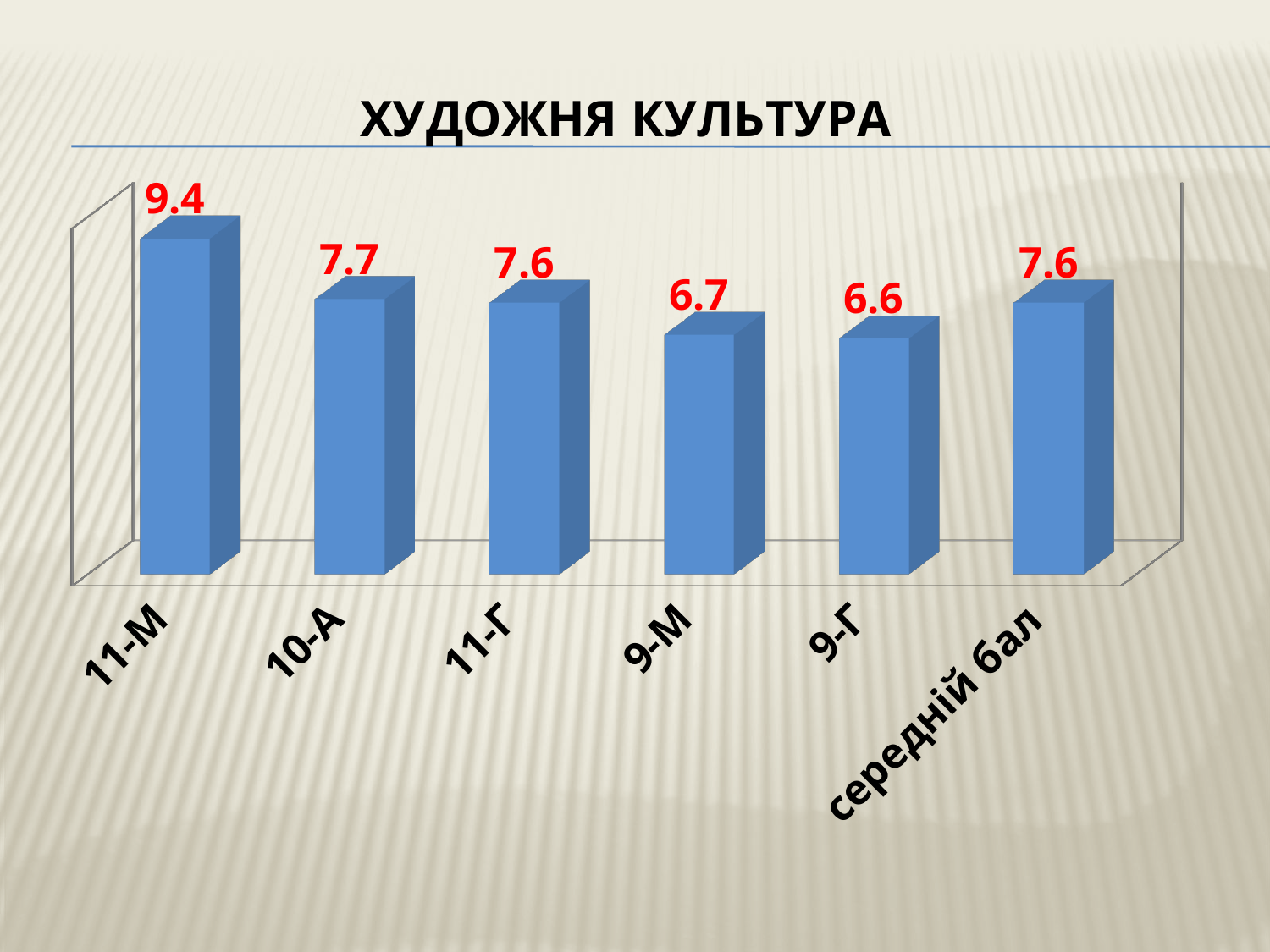
What is the title of the chart? ХУДОЖНЯ КУЛЬТУРА What is the difference between the values for 10-А and 9-М? 1.0 Which category has the lowest value? 9-Г Which is larger, the value for 11-Г or the value for 9-М? 11-Г Which category has the highest value? 11-М What is the value for 10-А? 7.7 What kind of chart is shown on the slide? bar chart What is the difference between the values for 11-М and 9-Г? 2.8 What is the value for 9-М? 6.7 How many categories are shown on the chart? 6 What is the value for 11-М? 9.4 What is the value for середній бал? 7.6